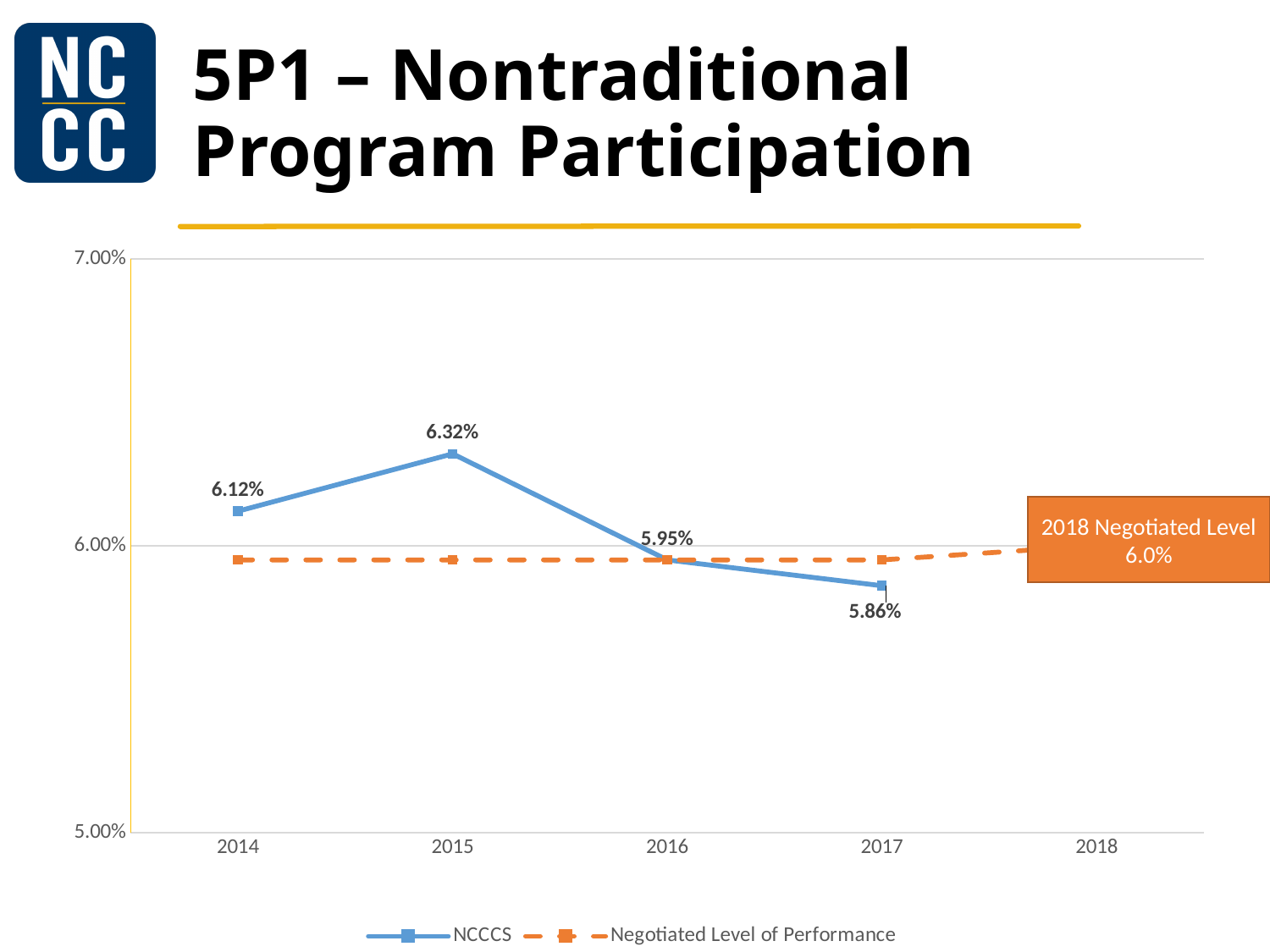
Which is larger, the NCCCS value for 2014 or for 2016? 2014 Is the NCCCS value for 2017 greater or less than 6.00%? less How many series does the legend list? 2 What is the NCCCS value for 2014? 6.12% What is the NCCCS value for 2017? 5.86% In which year is the NCCCS value highest? 2015 What is the difference between the NCCCS values for 2015 and 2017? 0.46% In which year is the NCCCS value lowest? 2017 What is the 2018 Negotiated Level shown in the callout box? 6.0% What is the NCCCS value for 2015? 6.32% What is the NCCCS value for 2016? 5.95% What kind of chart is shown on the slide? line chart